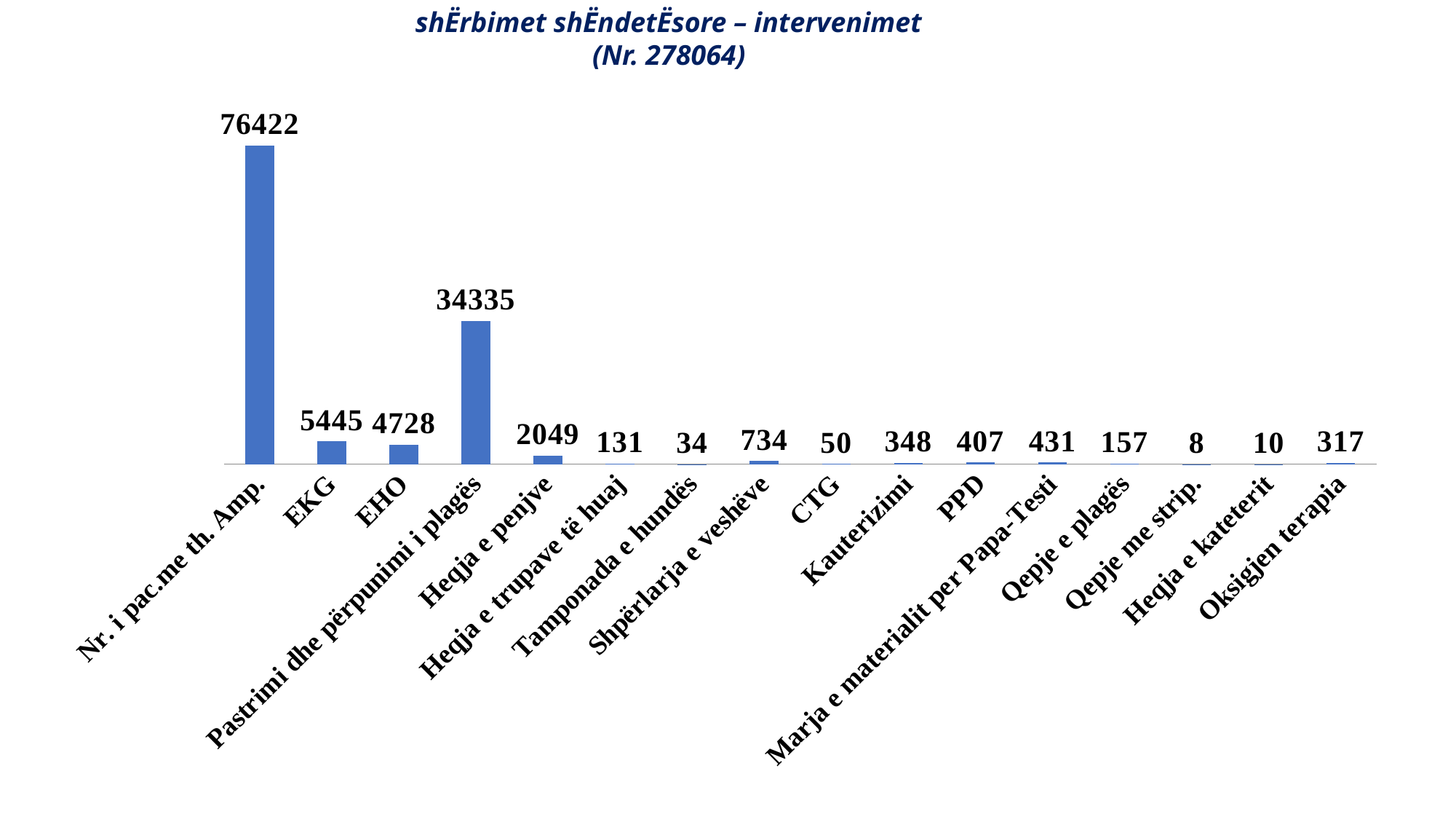
What is the value for EKG? 5445 What is the difference between the values for Nr. i pac.me th. Amp. and Pastrimi dhe përpunimi i plagës? 42087 Which category has the highest value? Nr. i pac.me th. Amp. What total number is given in the chart title? 278064 What kind of chart is shown on the slide? Bar chart What is the difference between the values for EKG and EHO? 717 What is the value for Heqja e penjve? 2049 Which category has the lowest value? Qepje me strip. How many categories are shown on the x axis? 16 Which is larger, the value for PPD or the value for Kauterizimi? PPD What is the value for Oksigjen terapia? 317 What is the value for Pastrimi dhe përpunimi i plagës? 34335